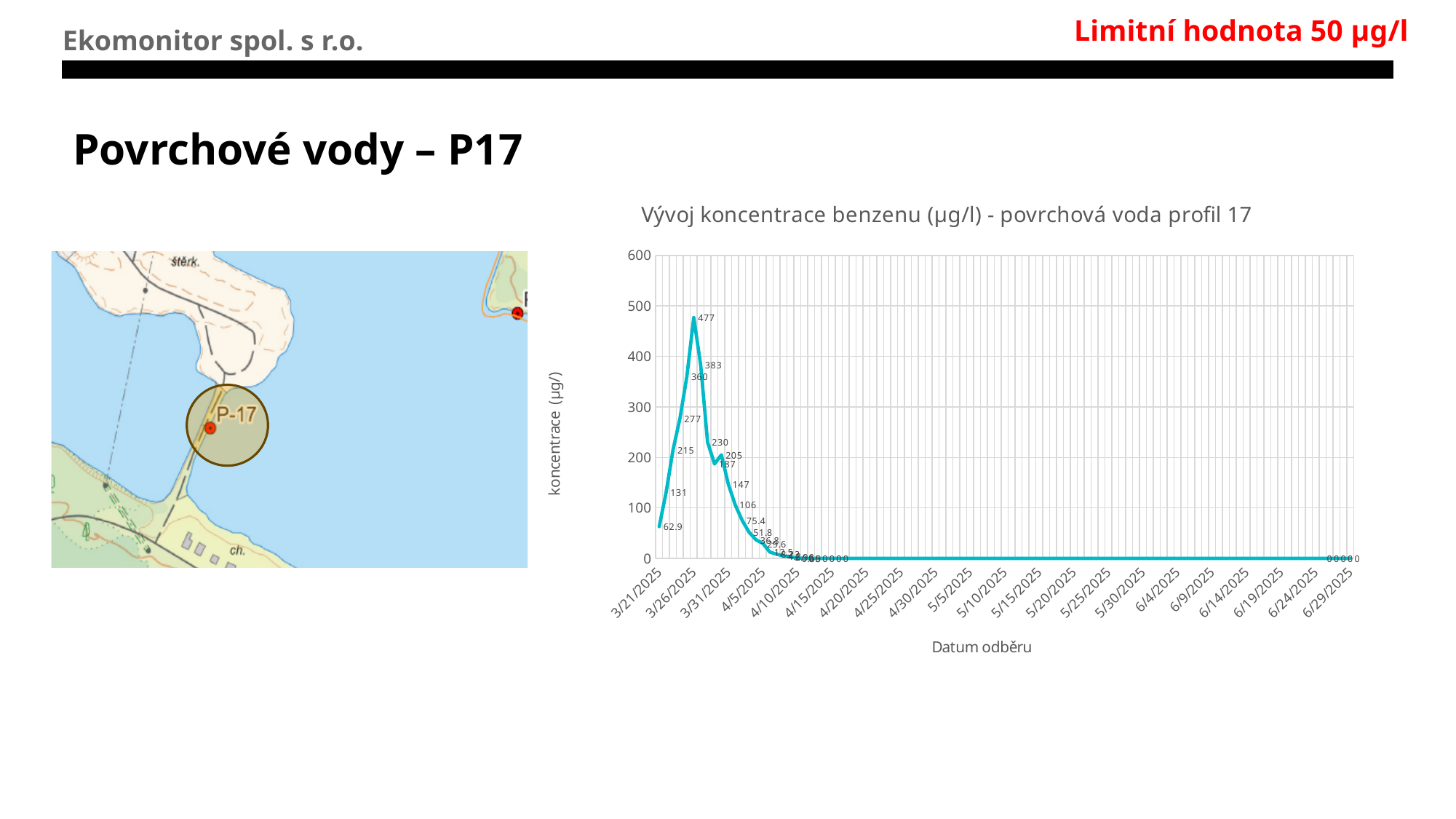
Is the peak value of the series greater or less than 400? greater What value is labelled at the last points of the series near 6/29/2025? 0 What is the difference between the peak value 477 and the first value 62.9? 414.1 What kind of chart is shown on the slide? line chart What is the title of the chart? Vývoj koncentrace benzenu (µg/l) - povrchová voda profil 17 Is the value labelled 147 greater or less than 100? greater What is the concentration value labelled at the first point of the series, on 3/21/2025? 62.9 Which labelled value is larger, 360 or 383? 383 What is the difference between the peak value 477 and the next labelled value 383? 94 What is the highest benzene concentration value labelled on the chart? 477 After reaching its peak, do the values rise or fall along the x axis? fall What is the title of the vertical axis? koncentrace (µg/l)